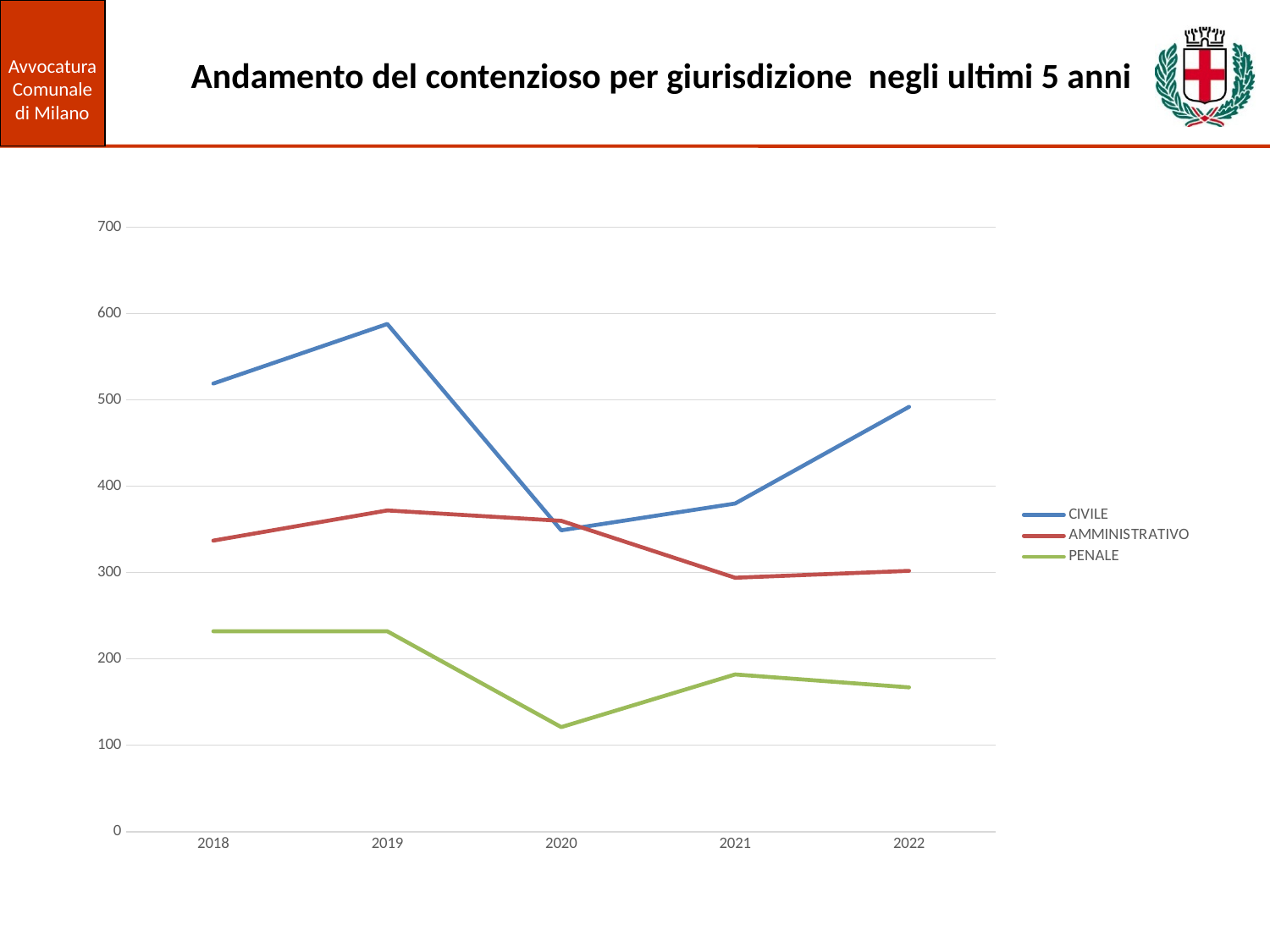
In which year does the CIVILE series reach its highest value? 2019 How many years are shown on the x axis? 5 Is the value for PENALE in 2020 greater or less than 200? less Is the value for CIVILE in 2019 greater or less than 500? greater What is the title of the chart on the slide? Andamento del contenzioso per giurisdizione negli ultimi 5 anni How many series does the legend list? 3 Is the value for AMMINISTRATIVO in 2019 greater or less than 400? less In which year does the CIVILE series reach its lowest value? 2020 Does the CIVILE series rise or fall from 2020 to 2022? rise In 2018, which series has the larger value, CIVILE or PENALE? CIVILE In which year does the PENALE series reach its lowest value? 2020 What kind of chart is shown on the slide? line chart